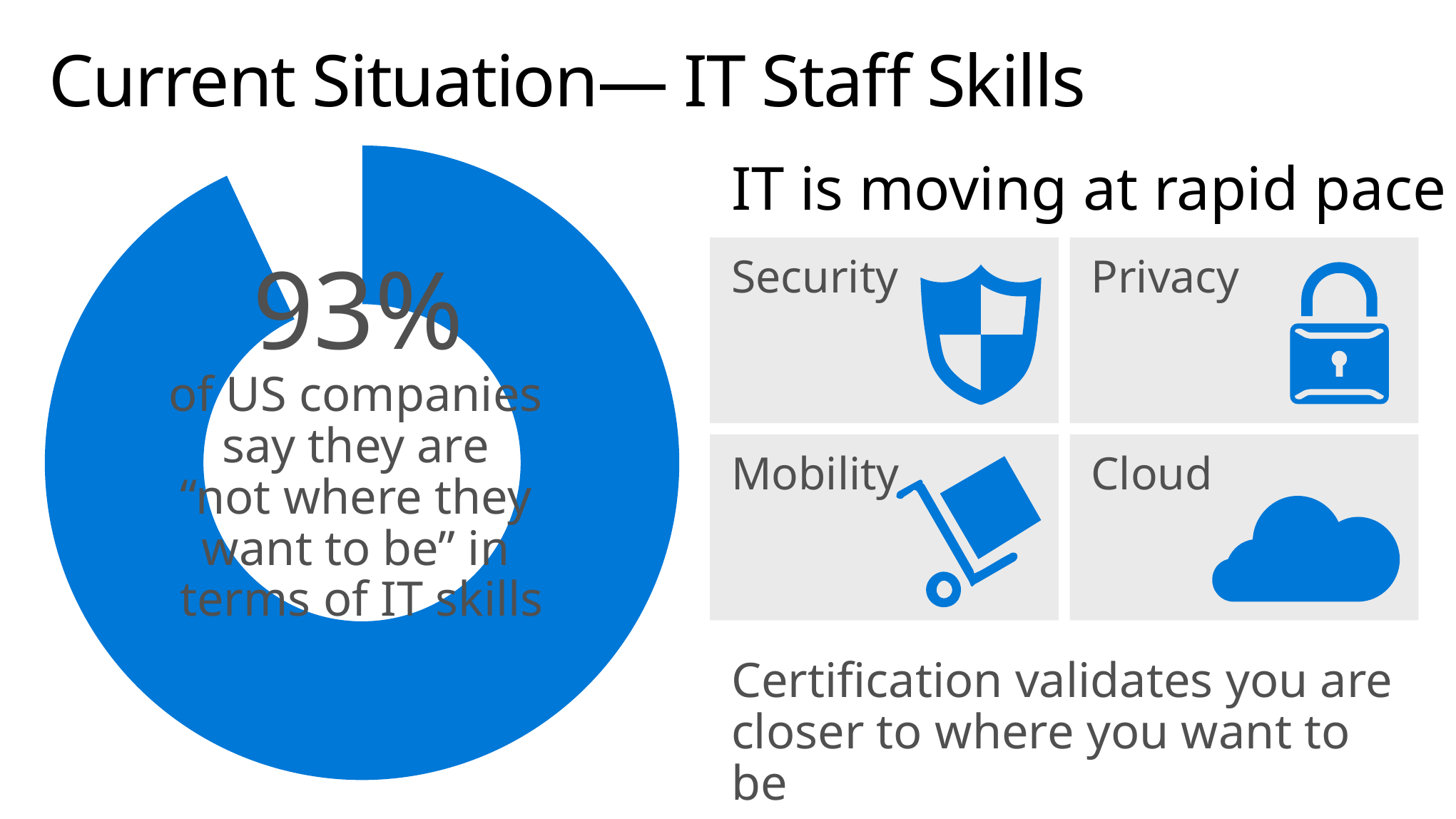
What percentage is displayed in the centre of the donut chart? 93% Is the highlighted share in the donut chart greater or less than 90%? greater How many segments does the donut chart have (filled segment plus gap)? 2 Is the highlighted share in the donut chart greater or less than 50%? greater Which segment of the donut chart is larger, the filled blue segment or the gap? The filled blue segment What kind of chart is shown on the left of the slide? Donut (pie) chart What colour is the filled segment of the donut chart? Blue What is the title of the slide containing the donut chart? Current Situation— IT Staff Skills According to the donut chart, what share of US companies say they are "not where they want to be" in terms of IT skills? 93%